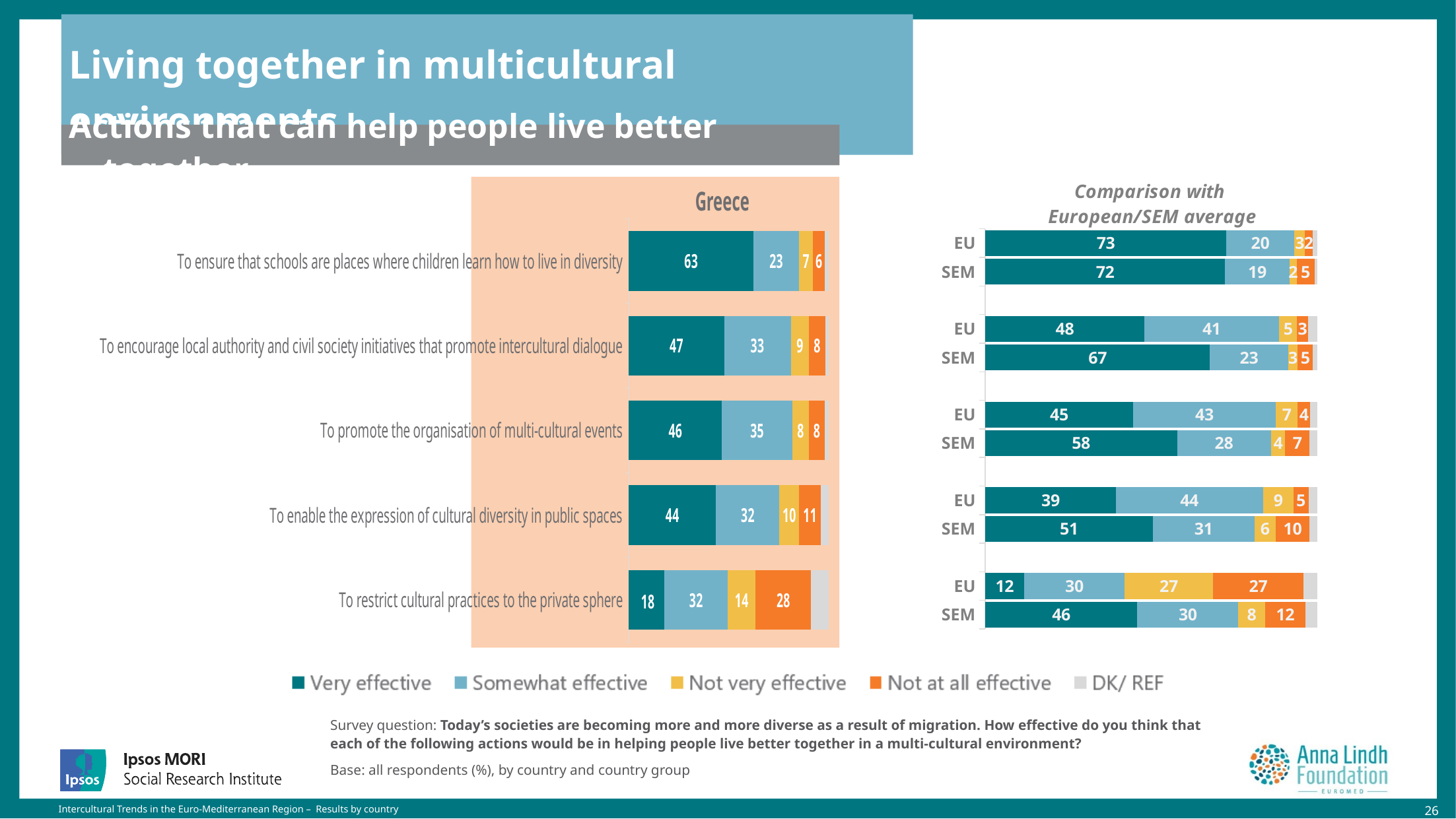
In the 'Comparison with European/SEM average' chart, what is the difference between the SEM and EU Very effective values in the second pair of bars (67 vs 48)? 19 In the Greece chart, which action has the highest Very effective value? To ensure that schools are places where children learn how to live in diversity What kind of chart is the Greece chart? Stacked bar chart How many series does the legend list? 5 In the Greece chart, what is the Not at all effective value for 'To restrict cultural practices to the private sphere'? 28 In the Greece chart, how much higher is the Very effective value for the schools action than for the local authority and civil society initiatives action? 16 In the Greece chart, which action has the lowest Very effective value? To restrict cultural practices to the private sphere In the 'Comparison with European/SEM average' chart, what is the Very effective value for the bottom SEM bar? 46 In the Greece chart, which has the larger Somewhat effective value: 'To promote the organisation of multi-cultural events' or 'To enable the expression of cultural diversity in public spaces'? To promote the organisation of multi-cultural events In the 'Comparison with European/SEM average' chart, what is the Very effective value for the top EU bar? 73 In the Greece chart, what percentage rated 'To ensure that schools are places where children learn how to live in diversity' as Very effective? 63 How many actions are listed in the Greece chart? 5